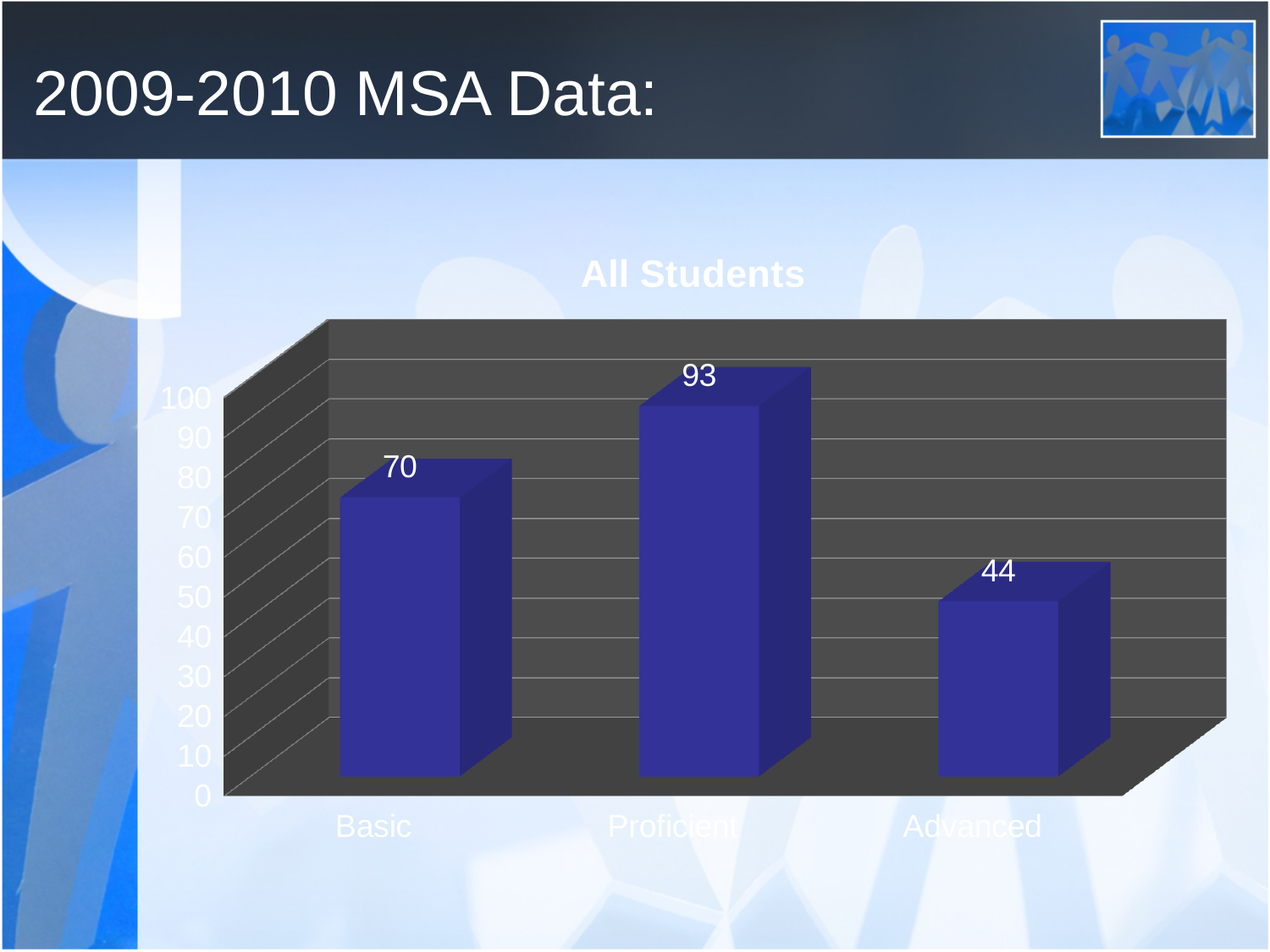
What is the value for Advanced? 44 What is the value for Basic? 70 Which is larger, the value for Basic or the value for Advanced? Basic What is the difference between the values for Proficient and Basic? 23 Is the value for Advanced greater or less than 50? less What is the difference between the values for Basic and Advanced? 26 What kind of chart is shown on the slide? bar chart How many categories are shown on the x axis? 3 What is the title of the chart? All Students What is the value for Proficient? 93 Which category has the lowest value? Advanced Which category has the highest value? Proficient